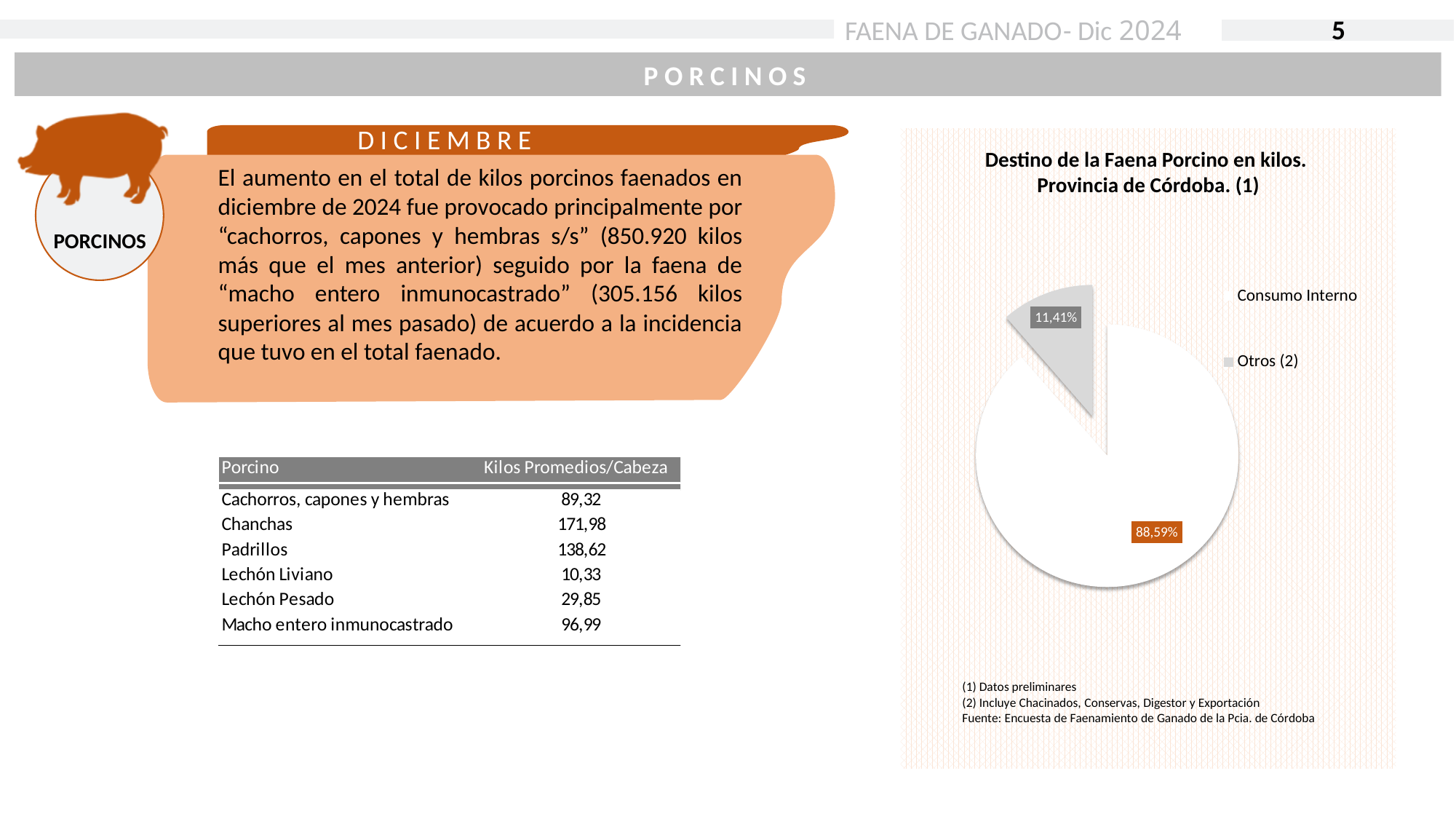
What is the title of the chart on the slide? Destino de la Faena Porcino en kilos. Provincia de Córdoba. (1) What is the total of the two slices shown in the pie chart? 100% Which legend entry is shown in grey in the pie chart? Otros (2) Which category has the largest slice in the pie chart? Consumo Interno Which category has the smallest slice in the pie chart? Otros (2) What share of the pie chart does Consumo Interno represent? 88,59% Is the share for Otros (2) in the pie chart greater or less than 50%? less How many slices does the pie chart have? 2 What is the difference in percentage points between the Consumo Interno slice and the Otros (2) slice? 77,18 Which is larger in the pie chart, Consumo Interno or Otros (2)? Consumo Interno What share of the pie chart does Otros (2) represent? 11,41% What kind of chart is shown on the slide? Pie chart